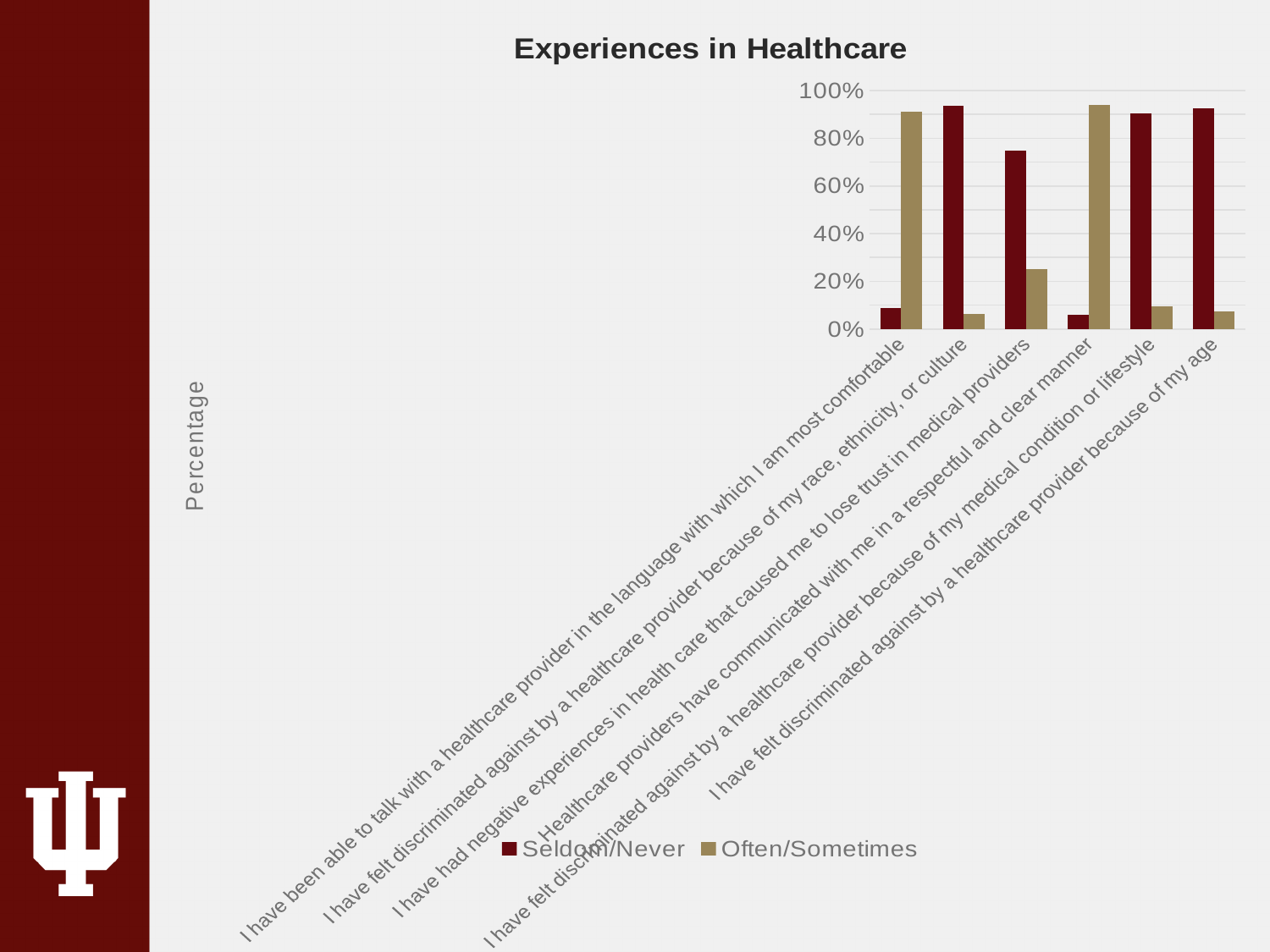
How many categories are shown on the x axis? 6 What is the label on the vertical axis? Percentage Is the Often/Sometimes value for "I have had negative experiences in health care that caused me to lose trust in medical providers" greater or less than 40%? less Is the Seldom/Never value for "Healthcare providers have communicated with me in a respectful and clear manner" greater or less than 20%? less For "Healthcare providers have communicated with me in a respectful and clear manner", which series has the larger value, Seldom/Never or Often/Sometimes? Often/Sometimes How many series does the legend list? 2 Is the Often/Sometimes value for "I have been able to talk with a healthcare provider in the language with which I am most comfortable" greater or less than 80%? greater Which category has the lowest Seldom/Never value? Healthcare providers have communicated with me in a respectful and clear manner For "I have had negative experiences in health care that caused me to lose trust in medical providers", which series has the larger value, Seldom/Never or Often/Sometimes? Seldom/Never What kind of chart is shown on the slide? bar chart What is the title of the chart? Experiences in Healthcare